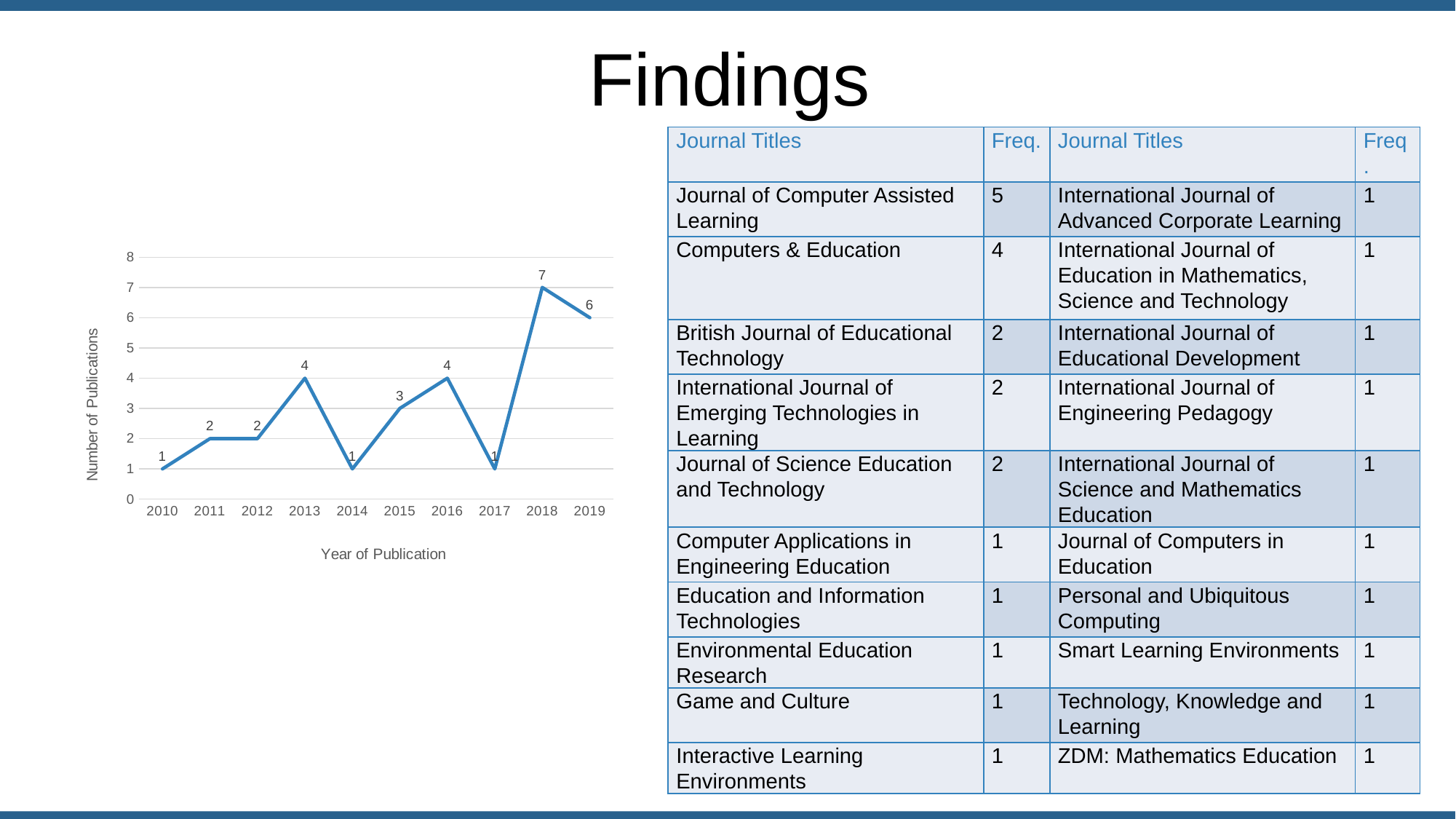
Which year has more publications, 2013 or 2014? 2013 What is the difference in number of publications between 2018 and 2017? 6 What is the label of the y axis? Number of Publications What is the number of publications in 2019? 6 Is the number of publications in 2019 greater or less than 5? greater What is the number of publications in 2018? 7 What is the number of publications in 2015? 3 How many years are plotted on the x axis? 10 What is the label of the x axis? Year of Publication Do the number of publications rise or fall from 2017 to 2018? rise What type of chart is shown on the slide? line chart Which year has the highest number of publications? 2018